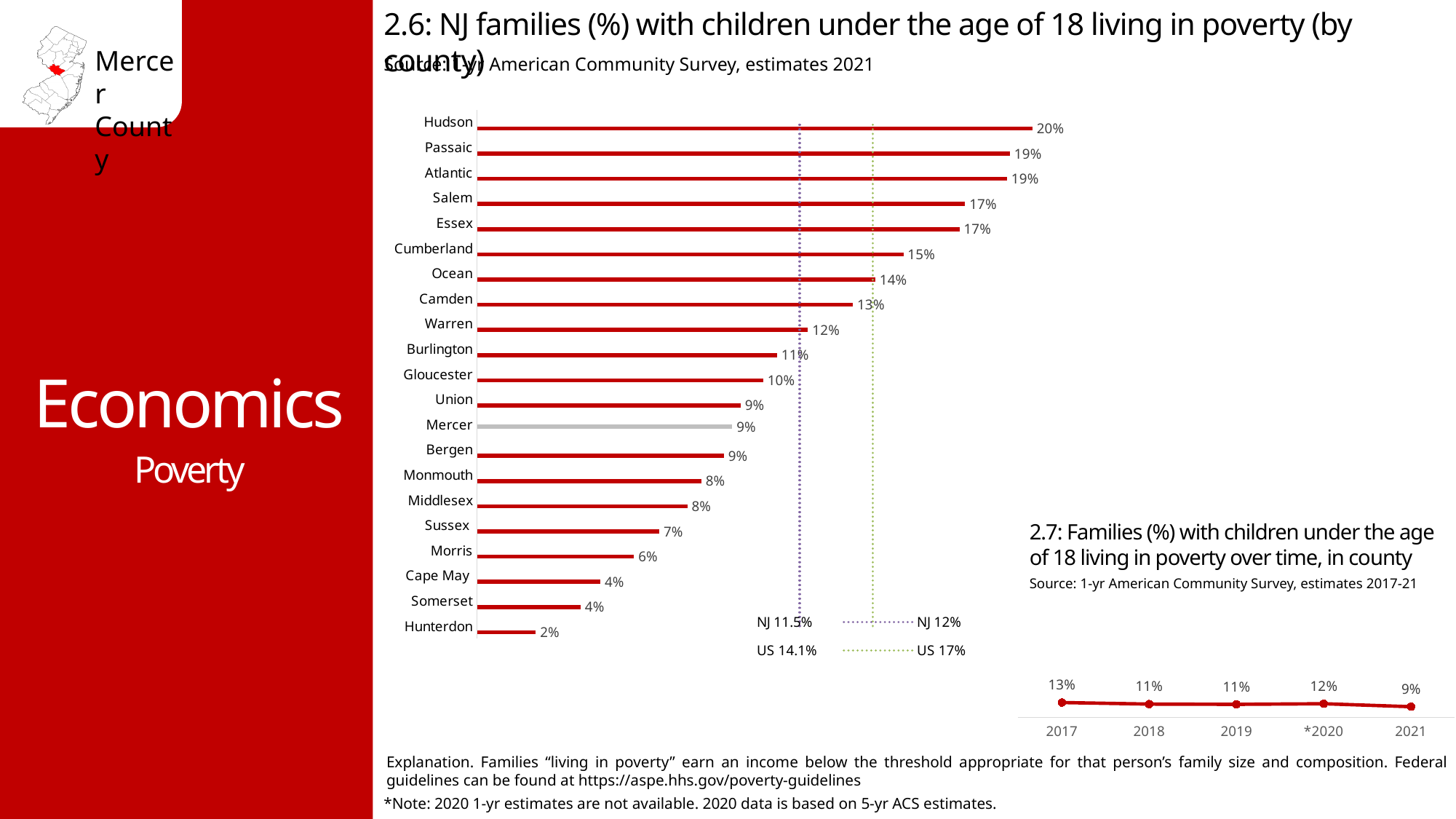
In chart 2.6, which has a larger value, Cumberland or Camden? Cumberland In chart 2.7, do the values generally rise or fall from 2017 to 2021? Fall In chart 2.6, which county has the highest value? Hudson In chart 2.6, how many counties are plotted? 21 In chart 2.6, what is the value for Hudson? 20% In chart 2.6, what is the difference between the values for Hudson and Hunterdon? 18% In chart 2.6, what is the value for Mercer? 9% In chart 2.7, what is the value for 2017? 13% What kind of chart is chart 2.6? Bar chart In chart 2.7, what is the difference between the values for 2017 and 2021? 4% In chart 2.6, which county has the lowest value? Hunterdon